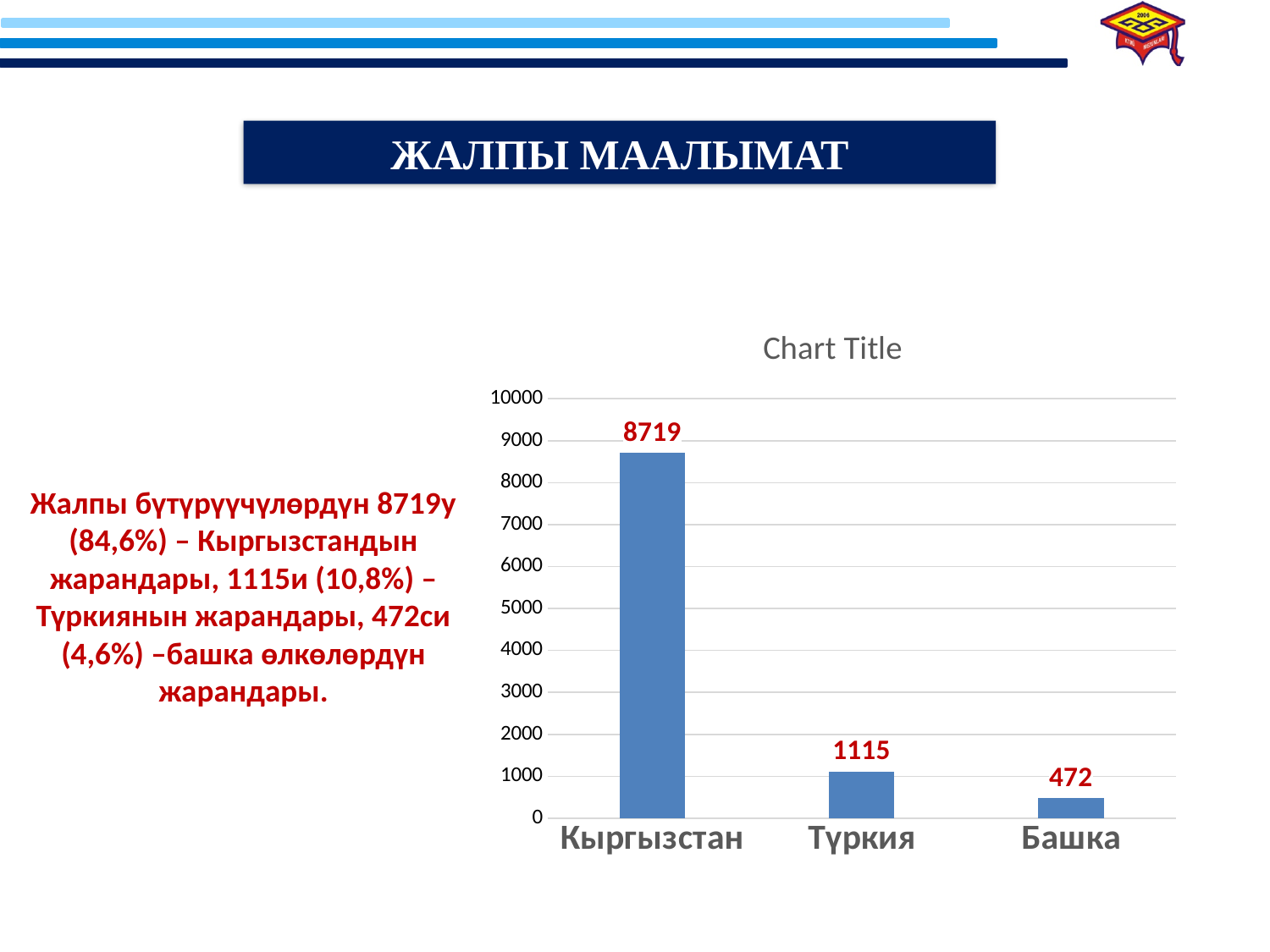
What kind of chart is shown on the slide? bar chart Which category has the highest value? Кыргызстан How many categories are shown on the x axis? 3 What is the value for Башка? 472 What is the title shown above the chart? Chart Title Which category has the lowest value? Башка Is the value for Түркия greater or less than 1000? greater What is the value for Түркия? 1115 What is the difference between the values for Кыргызстан and Түркия? 7604 What is the difference between the values for Түркия and Башка? 643 What is the value for Кыргызстан? 8719 Which is larger, the value for Түркия or the value for Башка? Түркия